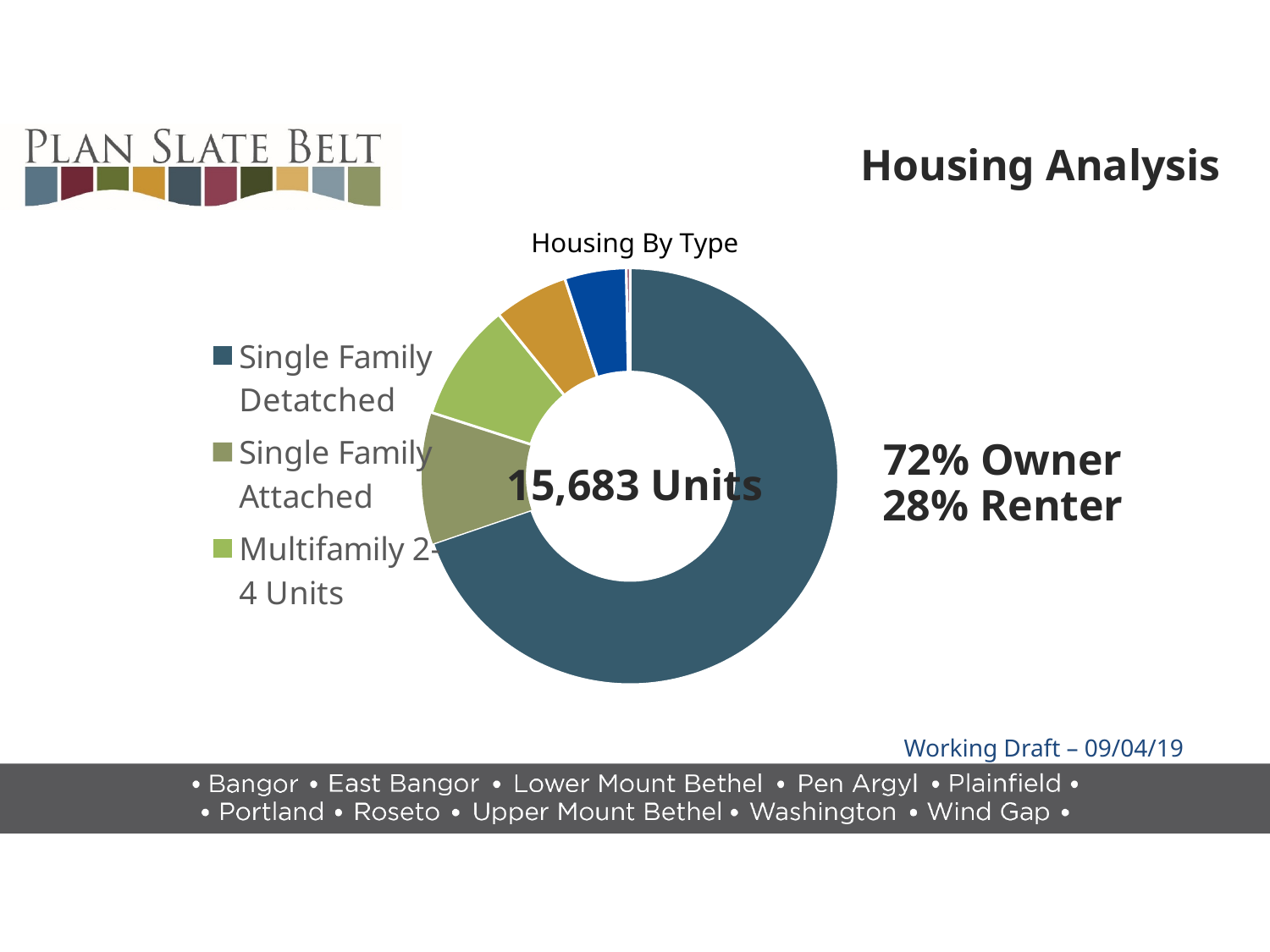
What total number of units is printed in the center of the Housing By Type chart? 15,683 Units Which housing type has the largest slice in the Housing By Type chart? Single Family Detatched What is the title of the chart? Housing By Type Does the Single Family Detatched slice take up more or less than half of the Housing By Type chart? more What kind of chart is shown on the slide? Pie chart (donut) Which slice is larger in the Housing By Type chart: Single Family Detatched or Single Family Attached? Single Family Detatched According to the text next to the chart, what percentage of housing is owner-occupied? 72% How many entries does the legend of the Housing By Type chart list? 3 According to the text next to the chart, what percentage of housing is renter-occupied? 28% Which slice is larger in the Housing By Type chart: Single Family Detatched or Multifamily 2-4 Units? Single Family Detatched What colour is the Single Family Detatched slice in the Housing By Type chart? Dark teal blue